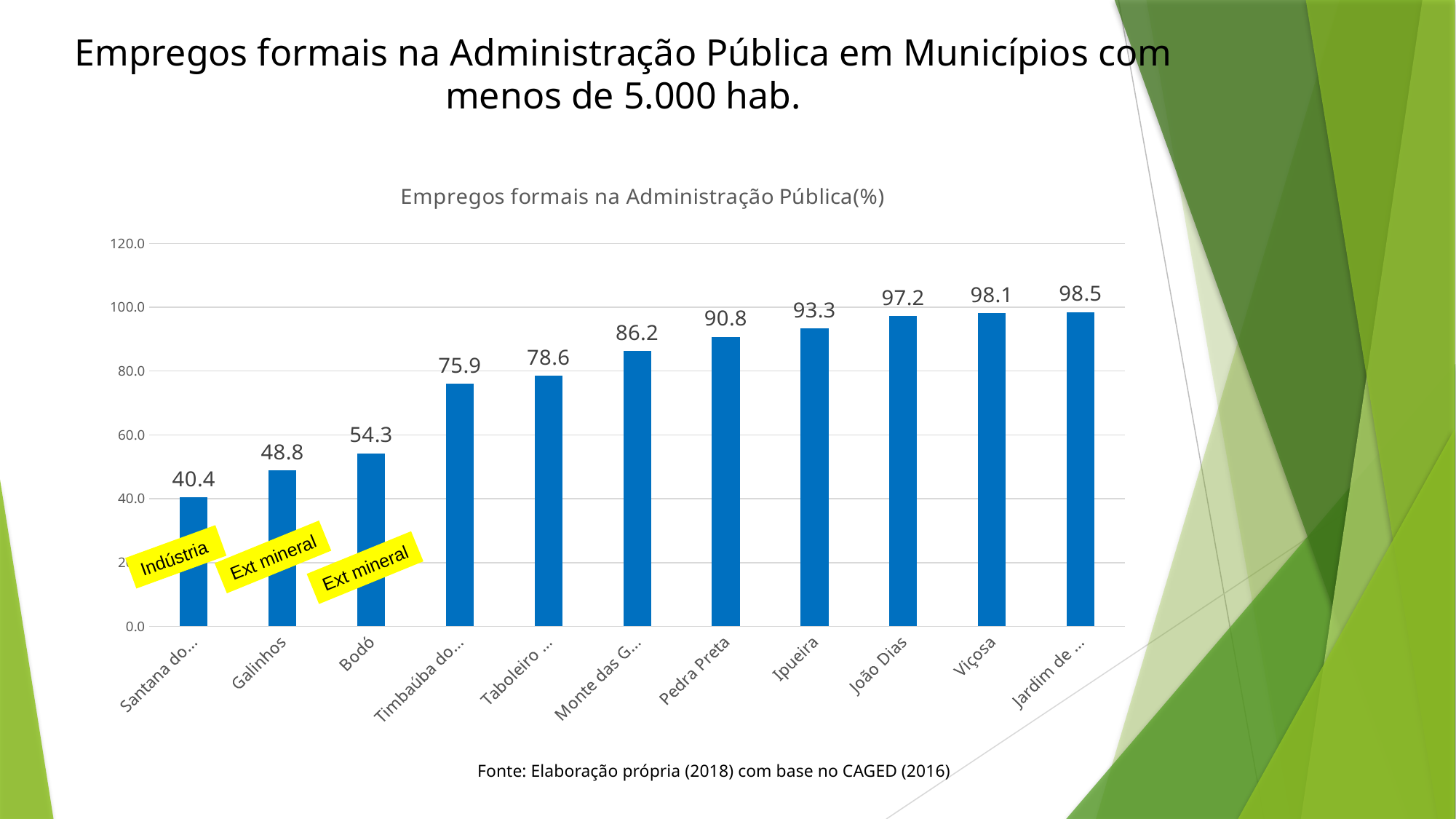
What is the difference between the values for Ipueira and Galinhos? 44.5 What is the lowest value shown in the chart? 40.4 How many municipalities (bars) are shown in the chart? 11 What is the value for João Dias? 97.2 Is the value for Bodó greater or less than 60? less Which has a larger value, Bodó or Galinhos? Bodó What is the value for Galinhos? 48.8 What is the value for Pedra Preta? 90.8 What kind of chart is shown on the slide? bar chart What is the highest value shown in the chart? 98.5 Do the values rise or fall from left to right along the x axis? rise What is the difference between the values for Viçosa and João Dias? 0.9